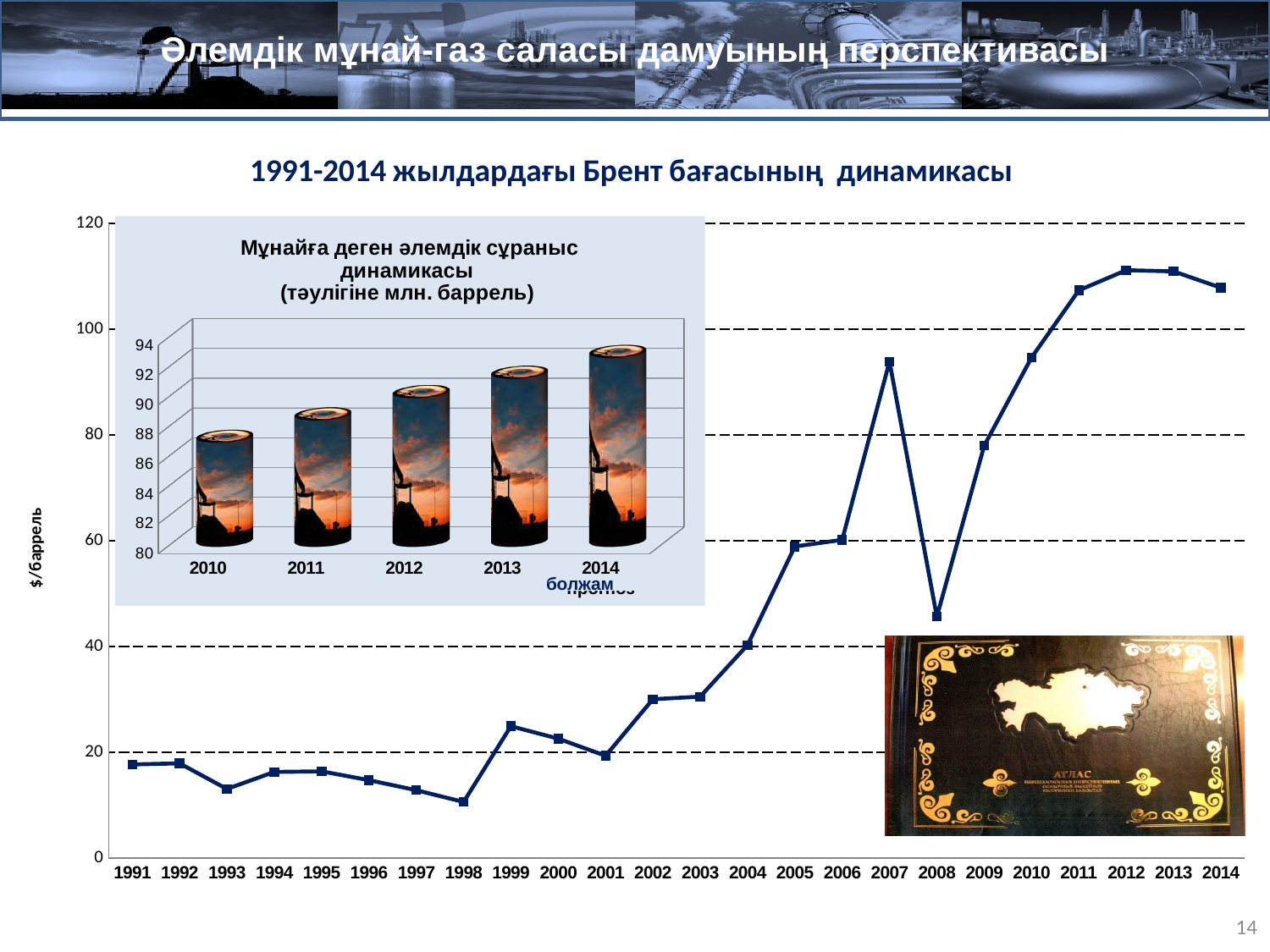
On the Brent price line chart, which year has the larger value, 2007 or 2008? 2007 On the Brent price line chart, is the value for 2011 greater or less than 100? greater On the inset chart titled 'Мұнайға деген әлемдік сұраныс динамикасы', what kind of chart is it? bar chart On the Brent price line chart, is the value for 2007 greater or less than 80? greater On the inset chart 'Мұнайға деген әлемдік сұраныс динамикасы', is the value for 2010 greater or less than 90? less On the inset chart 'Мұнайға деген әлемдік сұраныс динамикасы', do the values rise or fall from 2010 to 2014? rise On the Brent price line chart, how many years are shown on the x axis? 24 On the chart titled '1991-2014 жылдардағы Брент бағасының динамикасы', what kind of chart is used to show the Brent price? line chart On the Brent price line chart, which year has the lowest value? 1998 On the inset chart 'Мұнайға деген әлемдік сұраныс динамикасы', how many years are shown? 5 On the Brent price line chart, what is the label on the vertical axis? $/баррель